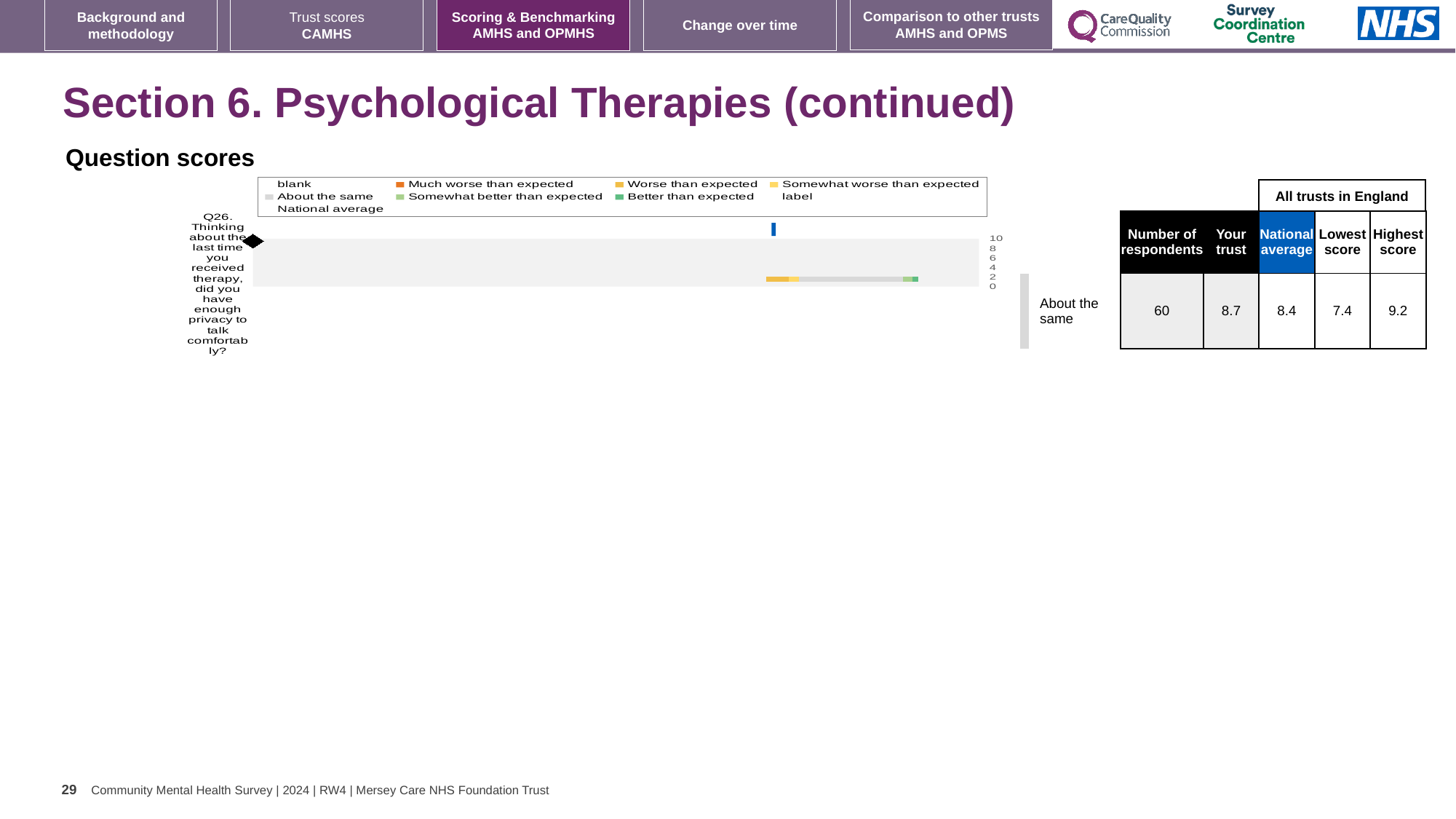
How many questions (categories) are plotted on the chart? 1 In the table beside the chart, what is the 'Your trust' score for Q26? 8.7 In the table beside the chart, what is the National average score for Q26? 8.4 In the table beside the chart, what is the Highest score among all trusts in England for Q26? 9.2 In the table beside the chart, what is the Lowest score among all trusts in England for Q26? 7.4 For Q26, which is larger: the 'Your trust' score or the National average? Your trust In the table beside the chart, how many respondents answered Q26? 60 For Q26, what is the difference between the Highest score and the Lowest score in the table? 1.8 What kind of chart is shown under 'Question scores'? bar chart What benchmark category is shown next to the chart for Q26? About the same Which question number is plotted on the chart? Q26 For Q26, what is the difference between the 'Your trust' score and the National average? 0.3